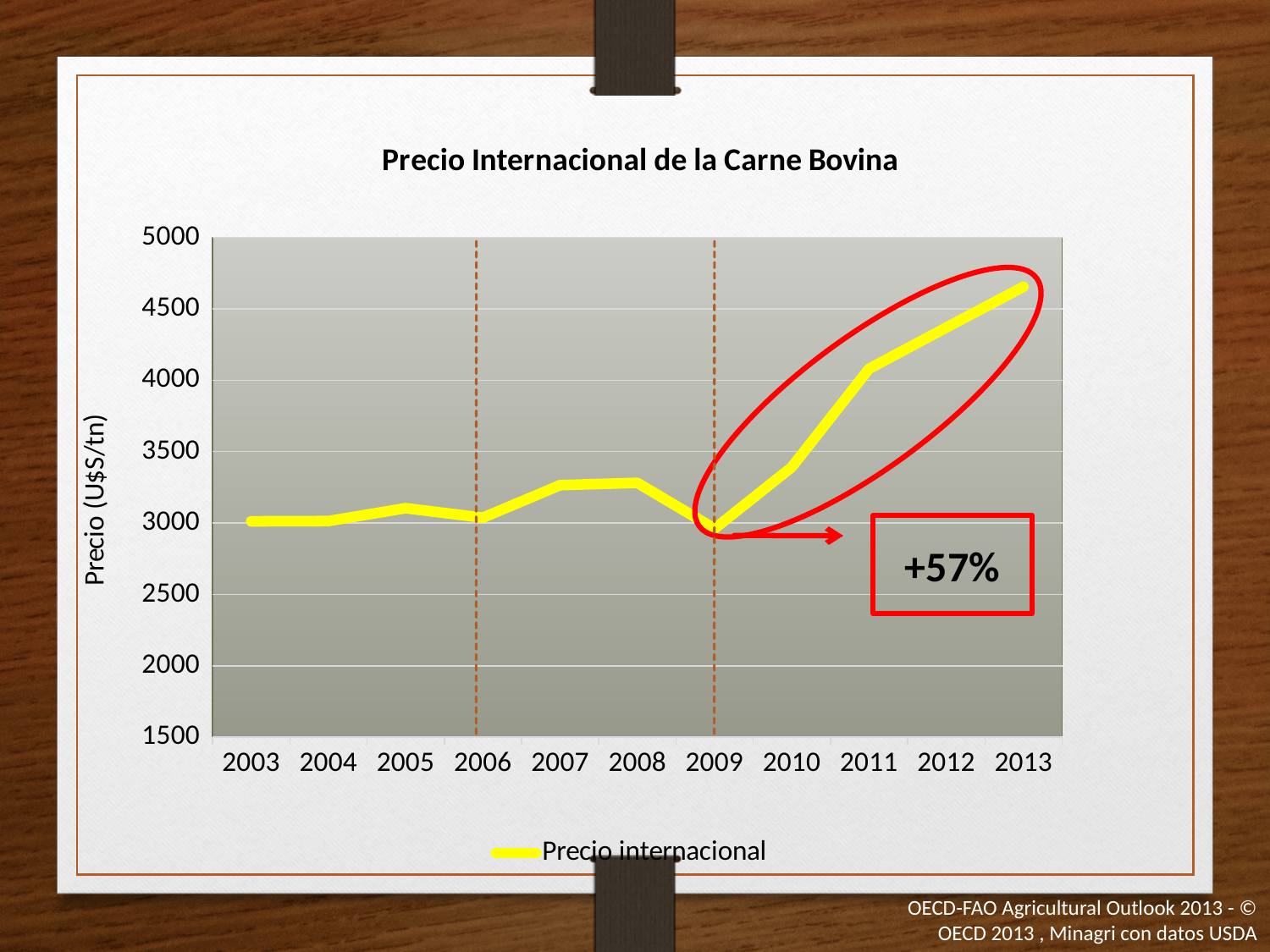
Is the value for 2007 greater or less than 3500? less What kind of chart is shown on the slide? line chart What percentage change is written in the red box on the chart? +57% What is the title of the chart? Precio Internacional de la Carne Bovina Which year has the larger value, 2013 or 2003? 2013 Do the values rise or fall from 2009 to 2013? rise Is the value for 2010 greater or less than 3500? less Is the value for 2013 greater or less than 4500? greater How many years are plotted along the x axis? 11 Which year has the highest price? 2013 How many series does the legend list? 1